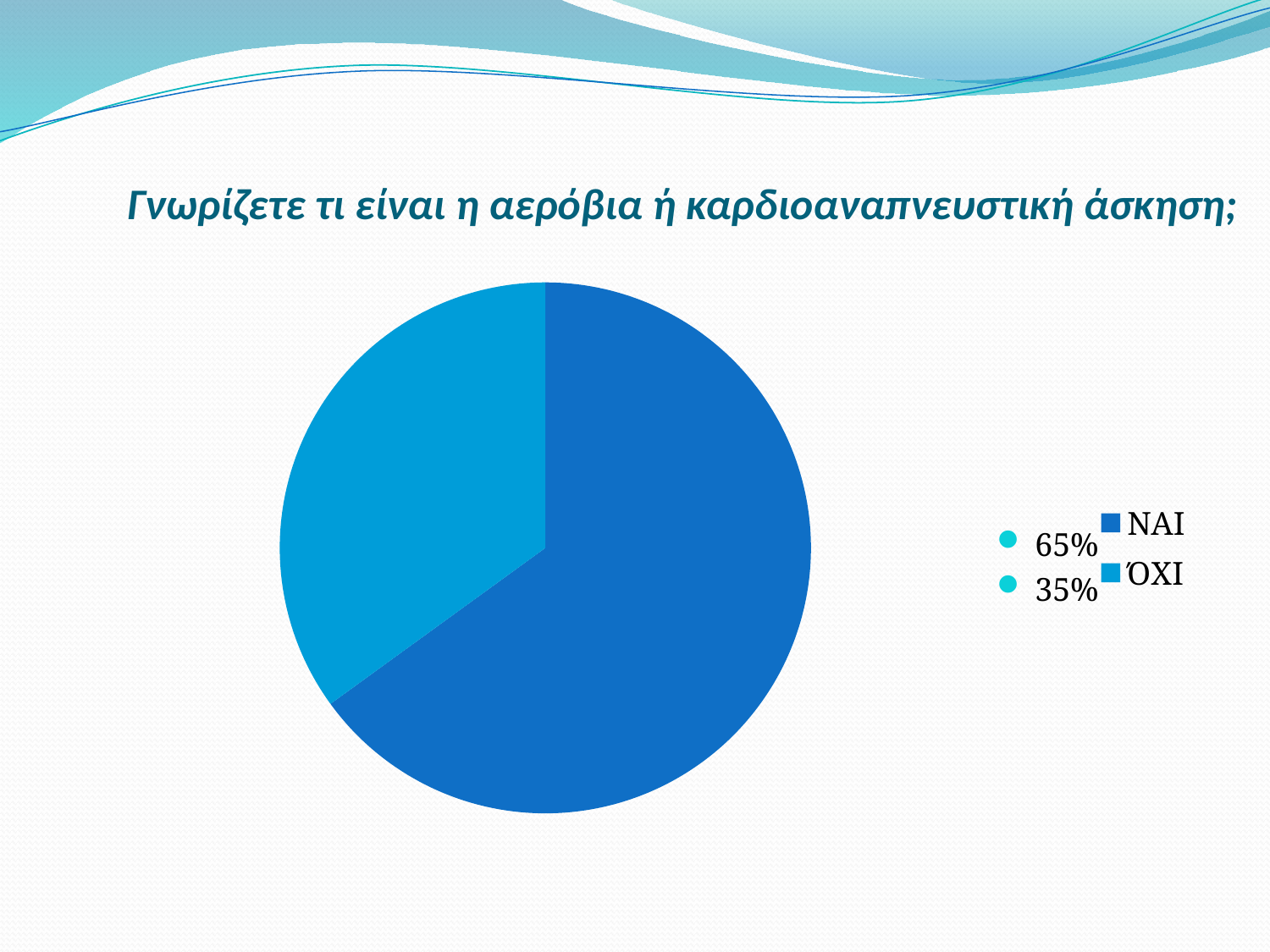
Which slice of the pie chart is the largest? ΝΑΙ What is the title of the chart on the slide? Γνωρίζετε τι είναι η αερόβια ή καρδιοαναπνευστική άσκηση; Is the share for ΝΑΙ greater or less than 50%? greater What is the difference in percentage points between the ΝΑΙ and ΌΧΙ slices? 30% Which is larger, the ΝΑΙ slice or the ΌΧΙ slice? ΝΑΙ What share of the pie does ΝΑΙ represent? 65% What kind of chart is shown on the slide? pie chart What share of the pie does ΌΧΙ represent? 35% Which legend entry is shown in the darker blue colour? ΝΑΙ Which slice of the pie chart is the smallest? ΌΧΙ How many entries does the legend of the pie chart list? 2 How many slices does the pie chart have? 2